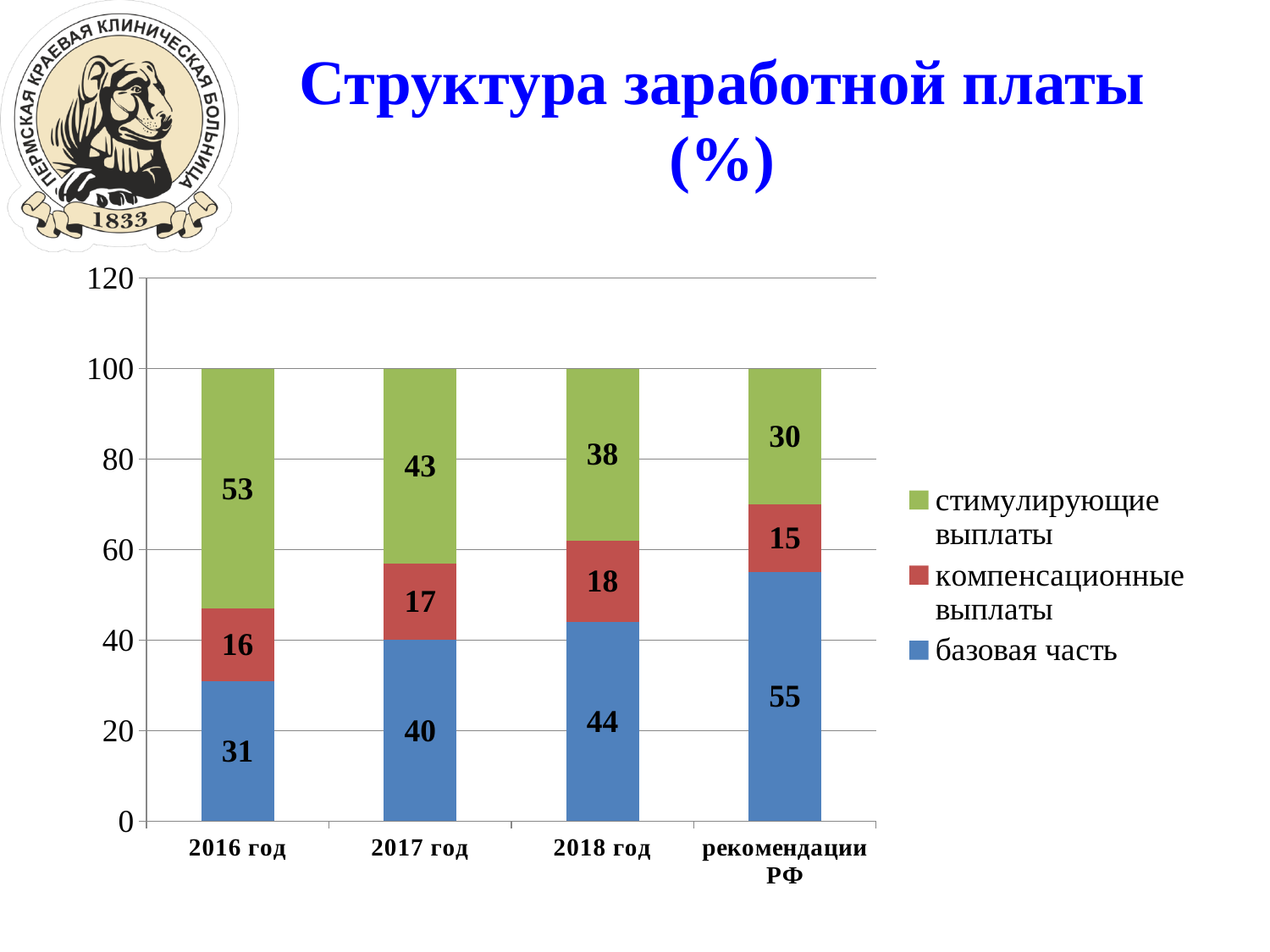
What is the value of компенсационные выплаты for 2018 год? 18 What is the value of базовая часть for рекомендации РФ? 55 Which category has the highest value for стимулирующие выплаты? 2016 год What is the difference between базовая часть for рекомендации РФ and for 2018 год? 11 What is the total of the stacked bar for 2018 год? 100 Which category has the lowest value for базовая часть? 2016 год What kind of chart is shown on the slide? Stacked bar chart How many categories are shown on the x axis? 4 What is the value of стимулирующие выплаты for 2017 год? 43 Which is larger: компенсационные выплаты for 2017 год or for рекомендации РФ? 2017 год How many series does the legend list? 3 What is the value of базовая часть for 2016 год? 31